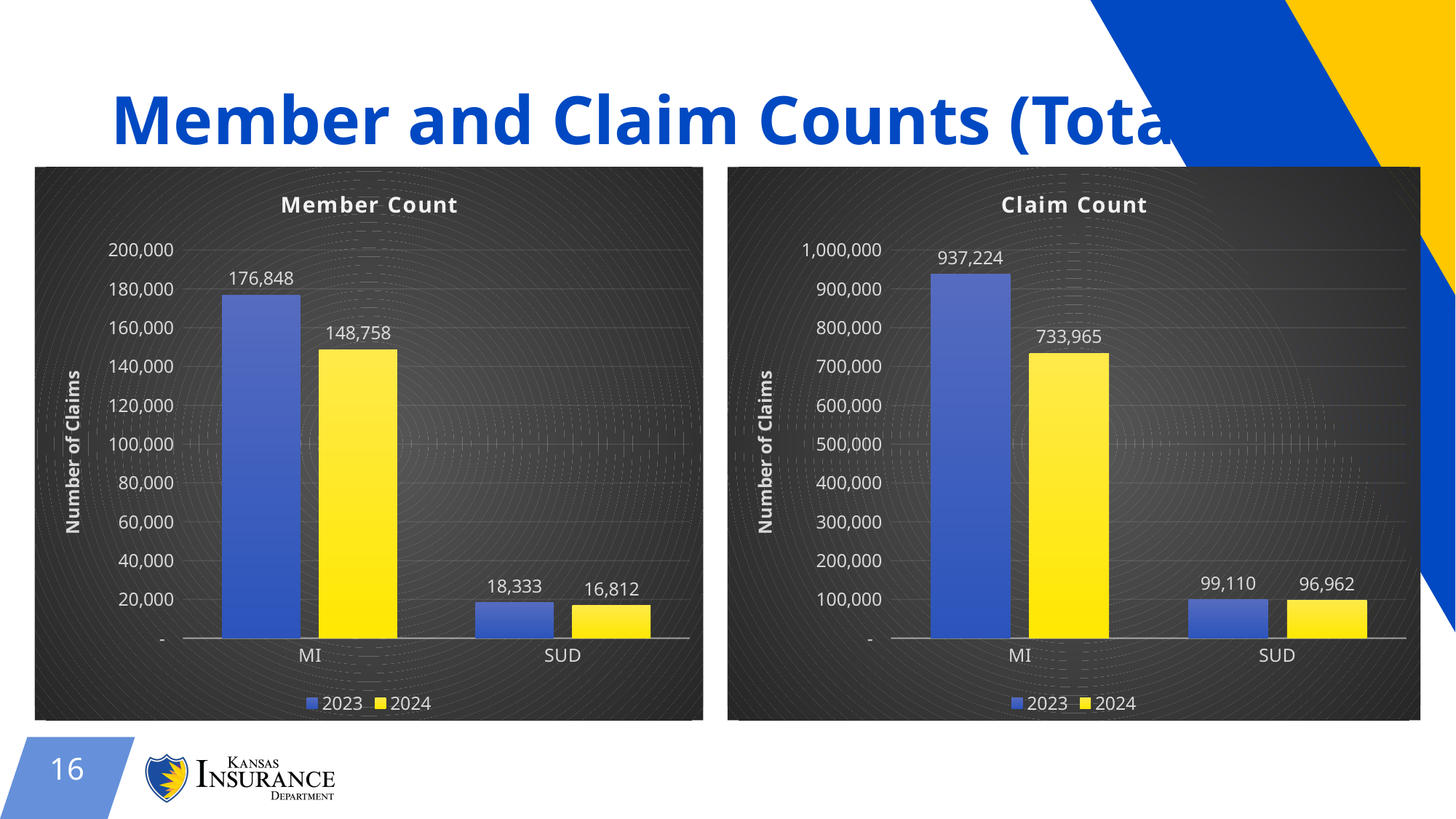
What kind of chart is the Member Count chart? bar chart In the Member Count chart, which bar has the lowest value? SUD 2024 In the Member Count chart, is the 2023 value for SUD larger or smaller than the 2024 value for SUD? larger How many series does the legend of the Claim Count chart list? 2 In the Member Count chart, what is the 2023 value for MI? 176,848 In the Claim Count chart, what is the difference between the 2023 and 2024 values for SUD? 2,148 In the Claim Count chart, what is the 2024 value for MI? 733,965 In the Claim Count chart, is the 2023 value for MI greater or less than 900,000? greater In the Claim Count chart, which category has the highest 2023 value? MI In the Member Count chart, what is the difference between the 2023 and 2024 values for MI? 28,090 In the Member Count chart, what is the 2024 value for SUD? 16,812 In the Claim Count chart, what is the 2023 value for SUD? 99,110